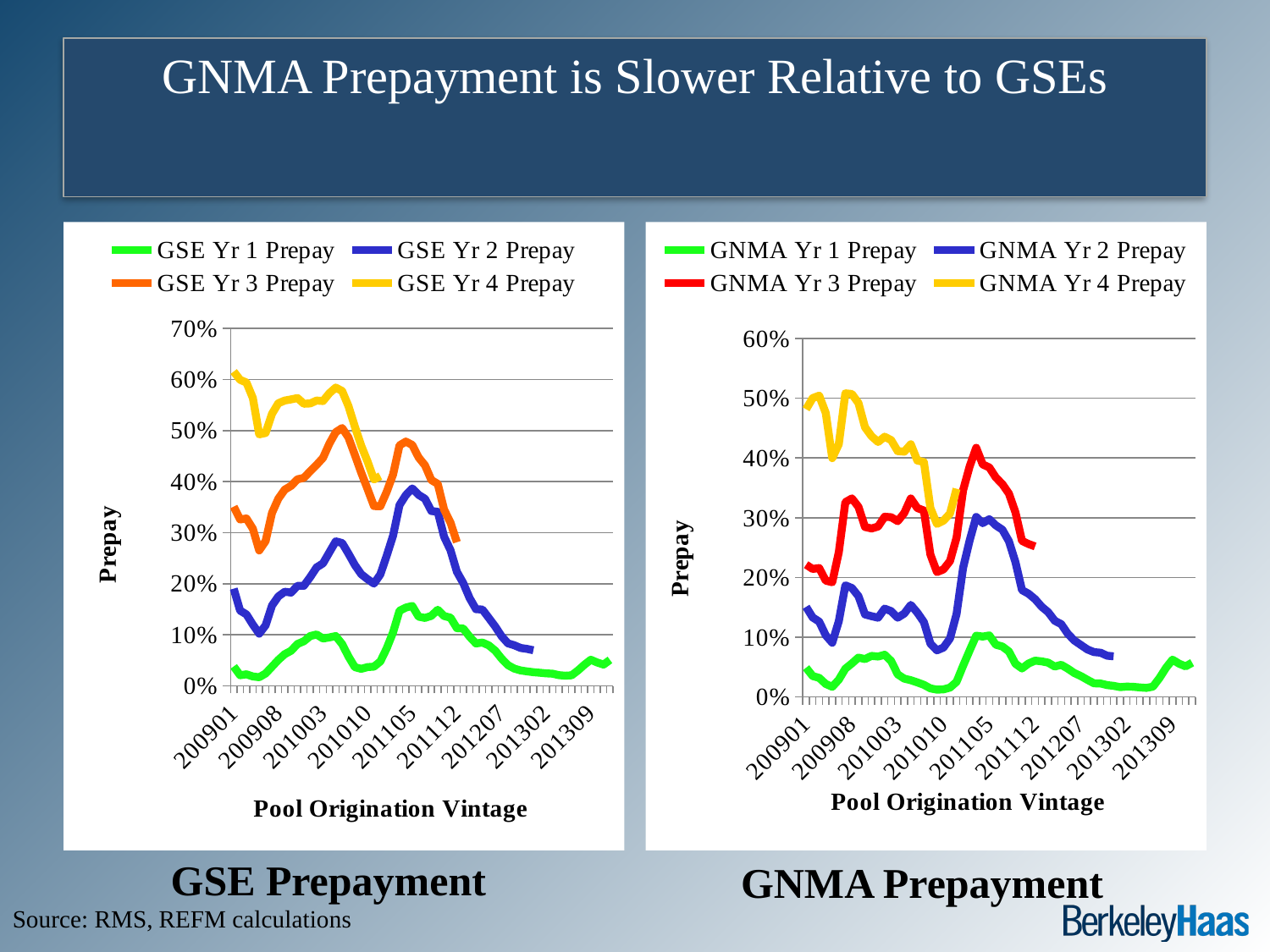
In the GSE Prepayment chart, is the value of GSE Yr 1 Prepay at 200901 greater or less than 10%? less In the GSE Prepayment chart, which series reaches the highest value? GSE Yr 4 Prepay How many series does the legend of the GSE Prepayment chart list? 4 In the GNMA Prepayment chart, at 200901 which is larger, GNMA Yr 4 Prepay or GNMA Yr 1 Prepay? GNMA Yr 4 Prepay What is the x-axis title of the GNMA Prepayment chart? Pool Origination Vintage How many series does the legend of the GNMA Prepayment chart list? 4 In the GSE Prepayment chart, does GSE Yr 4 Prepay rise or fall overall from 200901 to its last plotted vintage? fall In the GNMA Prepayment chart, which series has the lowest values across the vintages? GNMA Yr 1 Prepay In the GSE Prepayment chart, is the value of GSE Yr 4 Prepay at 200901 greater or less than 50%? greater What kind of chart is the GSE Prepayment chart on the left? line chart In the GNMA Prepayment chart, is the peak value of GNMA Yr 2 Prepay greater or less than 20%? greater